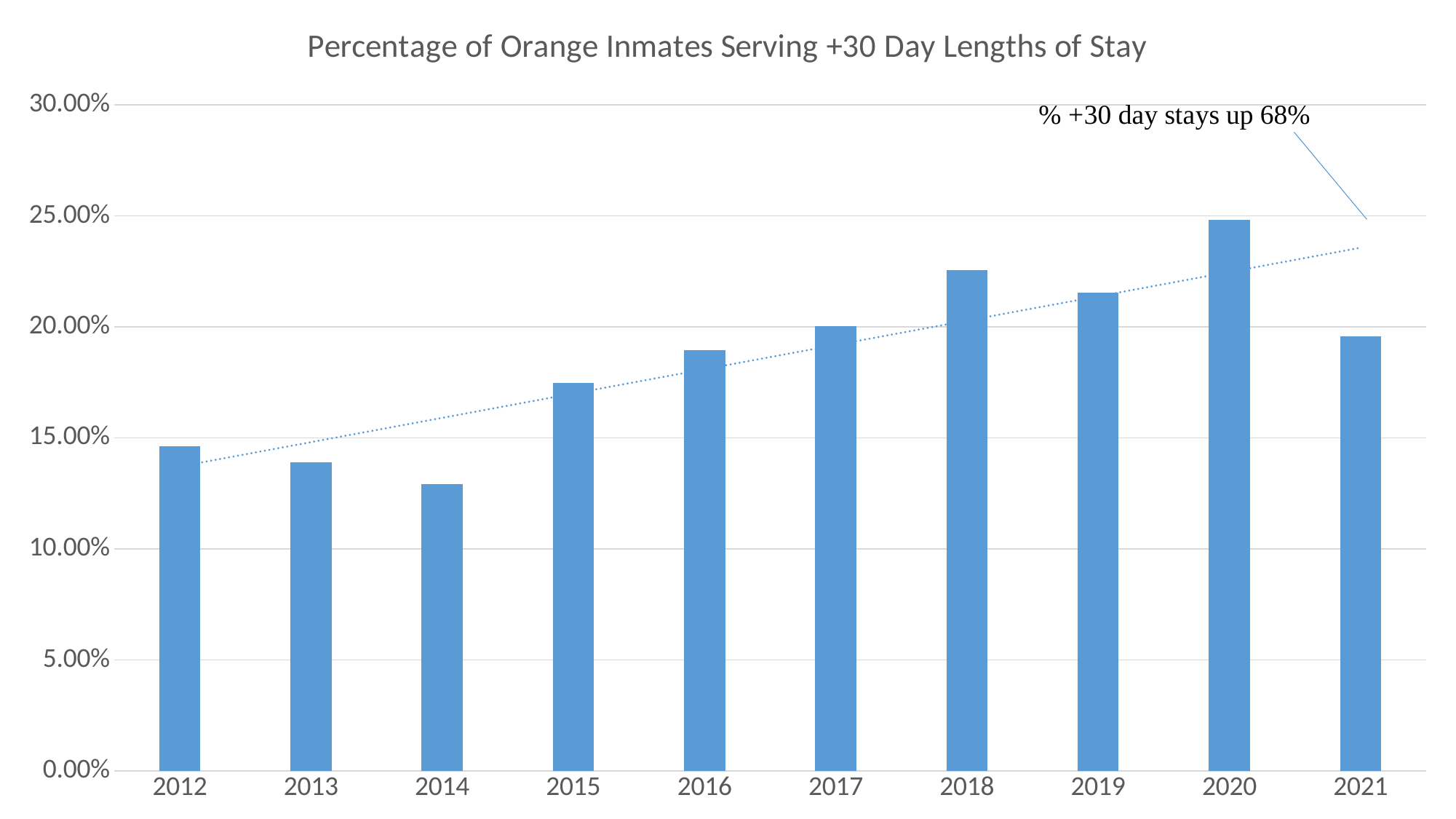
What is the title of the chart? Percentage of Orange Inmates Serving +30 Day Lengths of Stay Does the percentage of +30 day stays generally rise or fall from 2012 to 2020? rise What does the text annotation at the top right of the chart say? % +30 day stays up 68% Is the value for 2021 greater or less than 20.00%? less How many years are plotted on the x axis? 10 Which year has the lowest percentage of inmates serving +30 day stays? 2014 Which year has the larger value, 2018 or 2019? 2018 Is the value for 2018 greater or less than 20.00%? greater Which year has the highest percentage of inmates serving +30 day stays? 2020 Is the value for 2012 greater or less than 15.00%? less What kind of chart is shown on the slide? bar chart